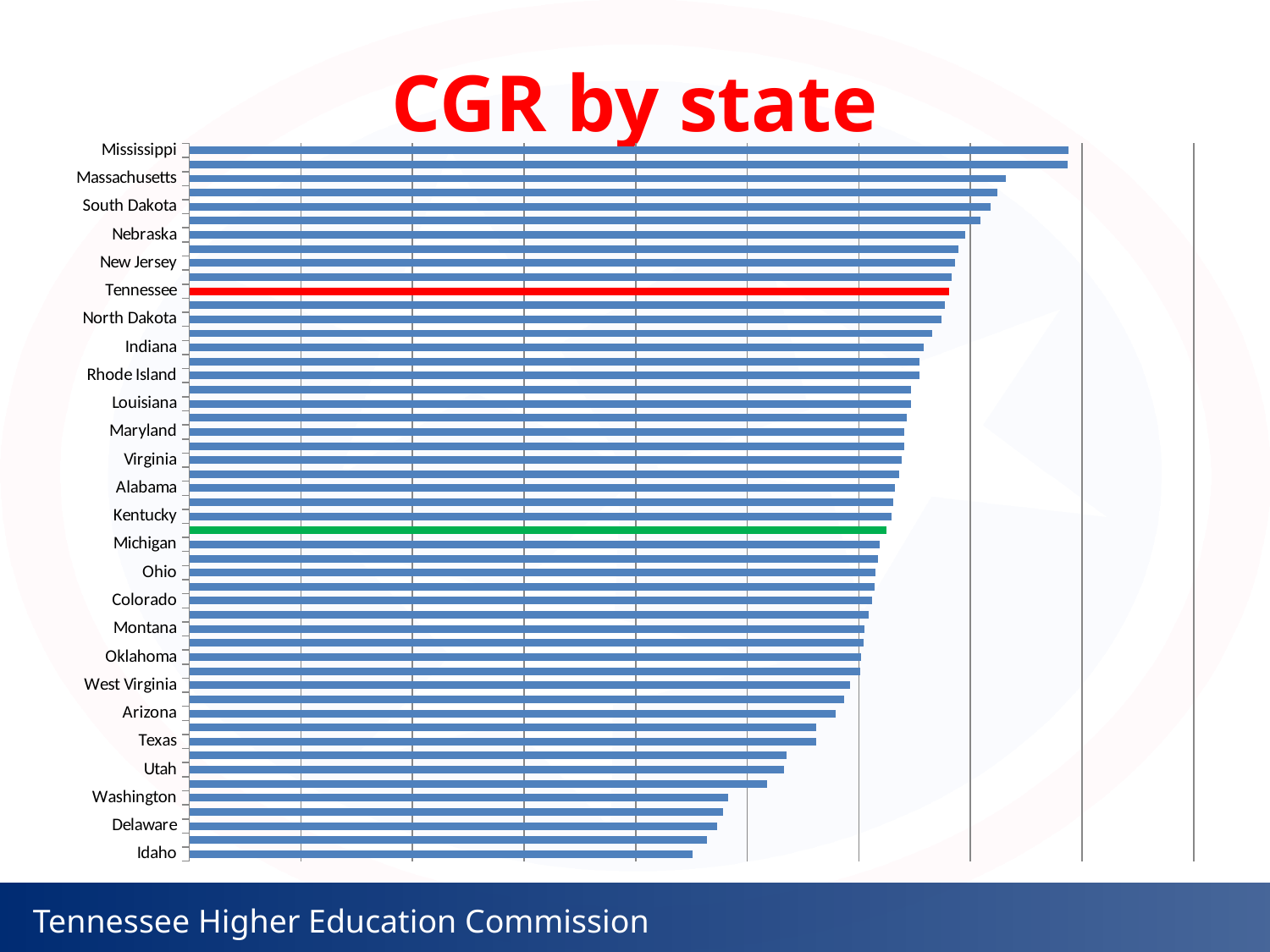
Do the bar values rise or fall going from the top of the chart to the bottom? Fall Which has the larger value, Mississippi or Idaho? Mississippi Which labeled state has the lowest value in the chart? Idaho Which has the larger value, Tennessee or Michigan? Tennessee Which state has the highest value in the chart? Mississippi How many state labels are shown on the vertical axis of the chart? 26 What kind of chart is shown on the slide? Bar chart Which has the larger value, Massachusetts or Texas? Massachusetts What is the title of the chart? CGR by state What colour is the bar for Tennessee? Red